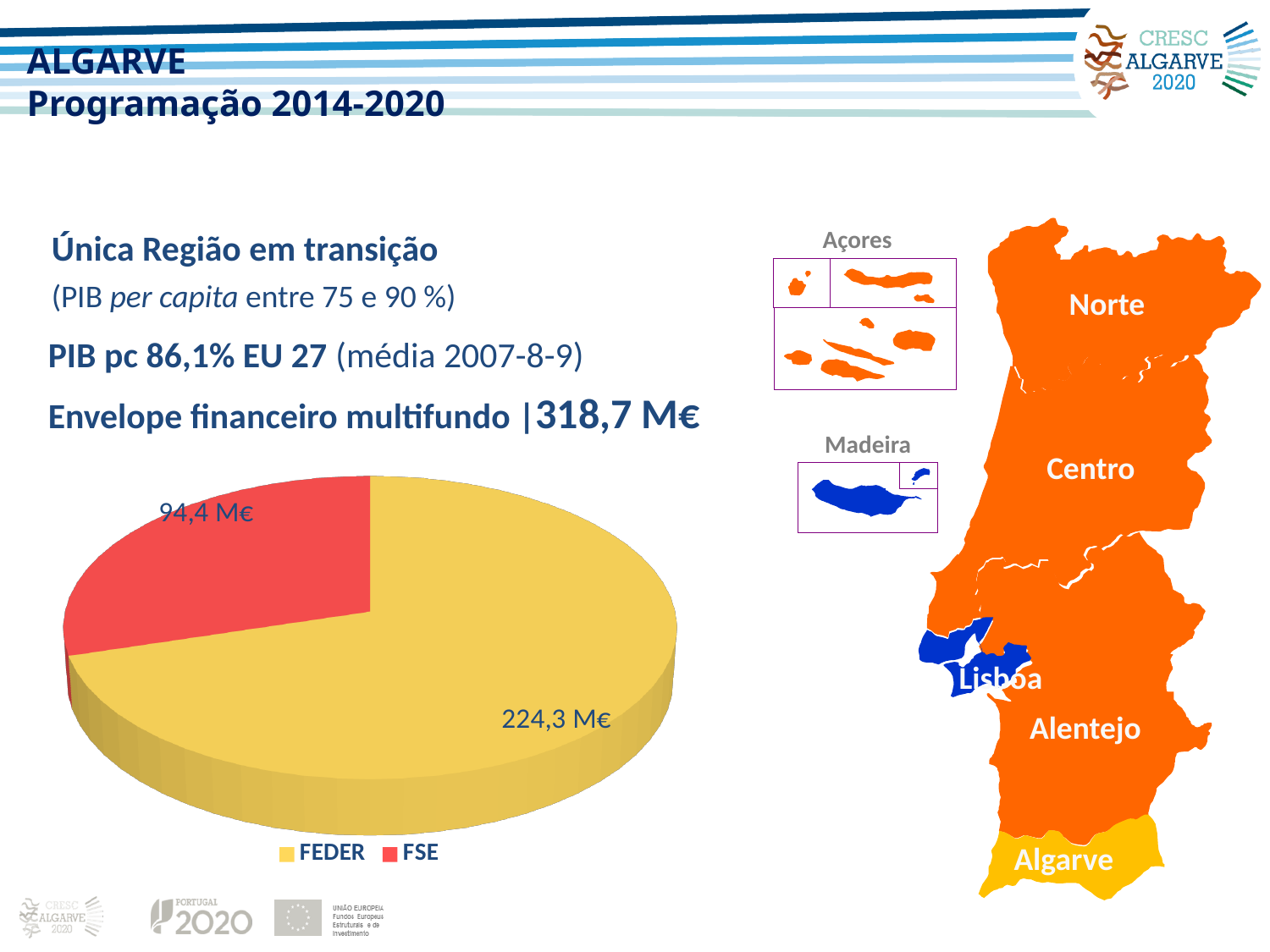
What is the value of the FSE slice in the pie chart? 94,4 M€ What is the value of the FEDER slice in the pie chart? 224,3 M€ Which slice of the pie chart is the smallest? FSE How many slices does the pie chart have? 2 What is the difference between the FEDER and FSE values in the pie chart? 129,9 M€ What is the total of the two slices in the pie chart? 318,7 M€ What colour is the FEDER slice in the pie chart? yellow Which fund has the larger slice in the pie chart, FEDER or FSE? FEDER What kind of chart is shown on the slide? pie chart How many entries does the pie chart legend list? 2 Which slice of the pie chart is the largest? FEDER What colour is the FSE slice in the pie chart? red